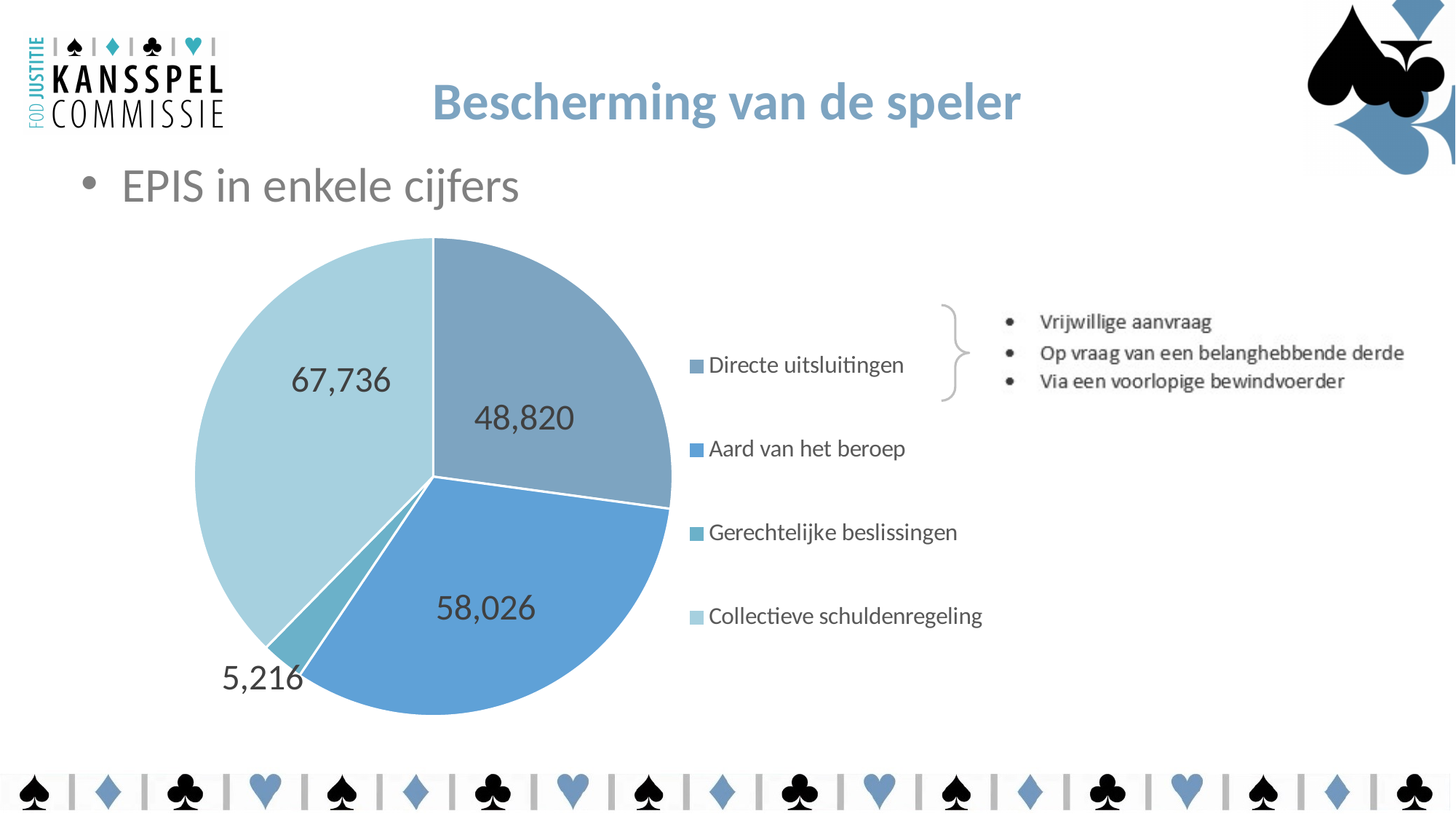
What value is shown for Collectieve schuldenregeling in the pie chart? 67,736 Which category has the largest slice in the pie chart? Collectieve schuldenregeling What value is shown for Aard van het beroep in the pie chart? 58,026 What is the total of all four slices in the pie chart? 179,798 What is the difference between the values for Collectieve schuldenregeling and Aard van het beroep? 9,710 What value is shown for Gerechtelijke beslissingen in the pie chart? 5,216 What is the difference between the values for Aard van het beroep and Directe uitsluitingen? 9,206 What kind of chart is shown on the slide? Pie chart How many categories does the pie chart show? 4 What value is shown for Directe uitsluitingen in the pie chart? 48,820 Which is larger: Directe uitsluitingen or Aard van het beroep? Aard van het beroep Which category has the smallest slice in the pie chart? Gerechtelijke beslissingen